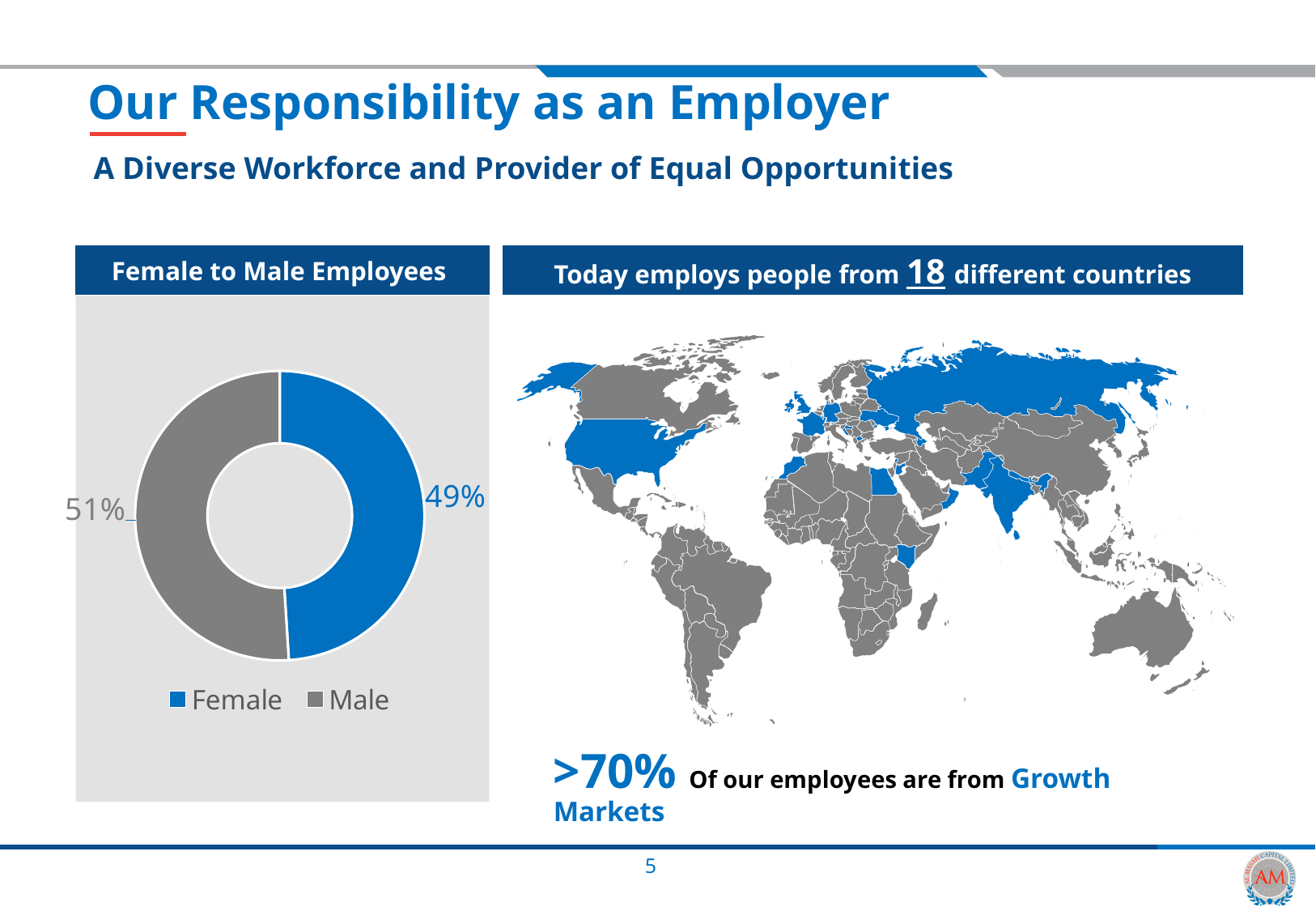
What percentage of employees are male according to the Female to Male Employees chart? 51% What percentage of employees are female according to the Female to Male Employees chart? 49% Which category has the larger share in the Female to Male Employees chart? Male What colour represents Female in the Female to Male Employees chart? Blue What kind of chart is the Female to Male Employees chart? Doughnut chart How many categories does the Female to Male Employees chart show? 2 What is the total of the Female and Male shares in the Female to Male Employees chart? 100% What is the difference in percentage points between the Male and Female shares in the Female to Male Employees chart? 2 percentage points Is the Female share in the Female to Male Employees chart greater or less than 50%? less Is the Female share larger or smaller than the Male share in the Female to Male Employees chart? smaller Which category has the smaller share in the Female to Male Employees chart? Female What is the title of the chart on the left of the slide? Female to Male Employees